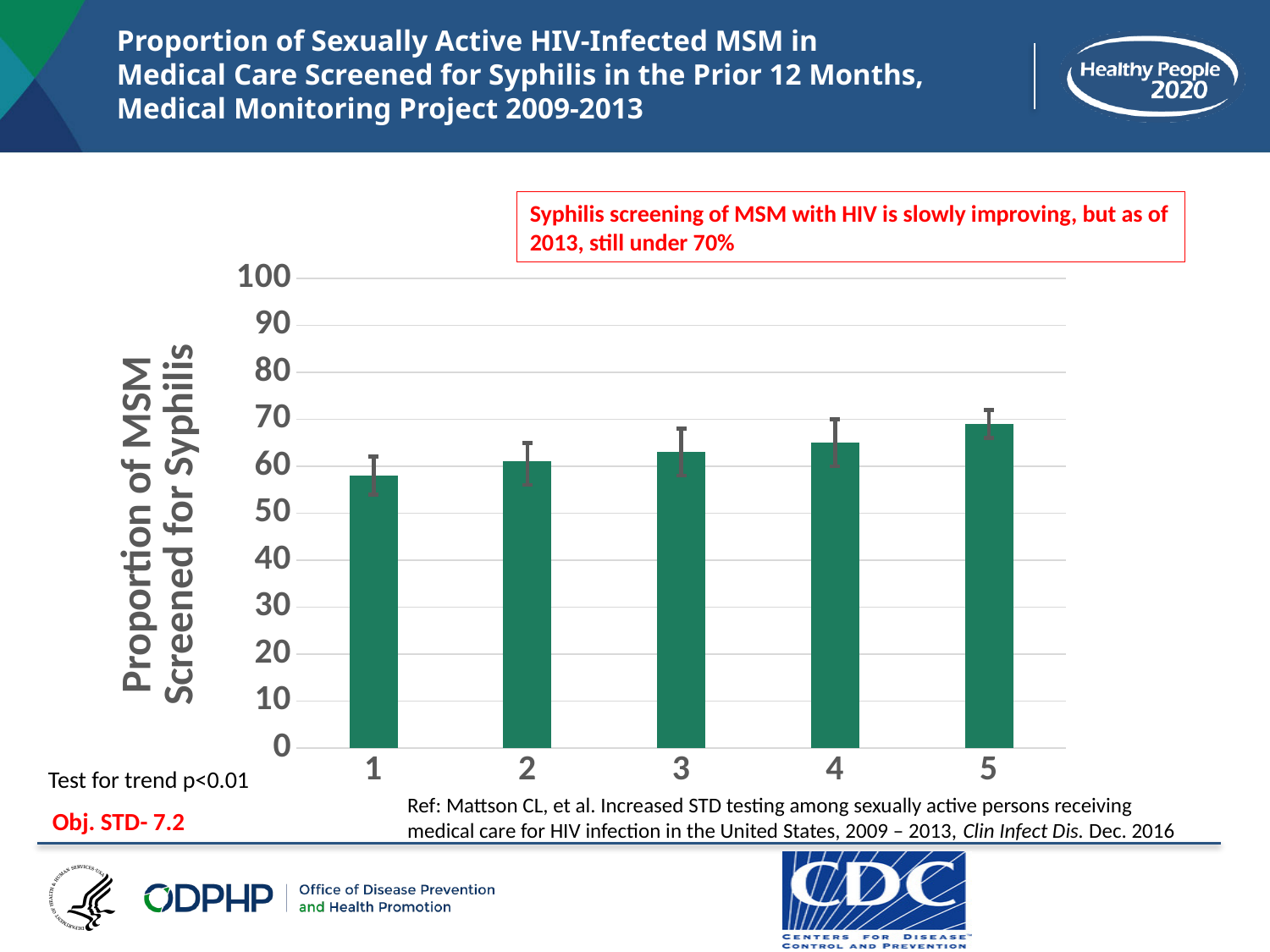
What p-value is reported for the test for trend on the slide? p<0.01 What kind of chart is shown on the slide? Bar chart Is the value for category 2 greater or less than 70? less How many bars (categories) are plotted on the chart? 5 Is the value for category 5 greater or less than 60? greater Which is larger, the value for category 4 or the value for category 2? Category 4 Which is larger, the value for category 5 or the value for category 1? Category 5 Do the bar values rise or fall from category 1 to category 5? Rise What is the label on the vertical axis of the chart? Proportion of MSM Screened for Syphilis Which category has the highest bar? 5 Which category has the lowest bar? 1 Is the value for category 1 greater or less than 50? greater